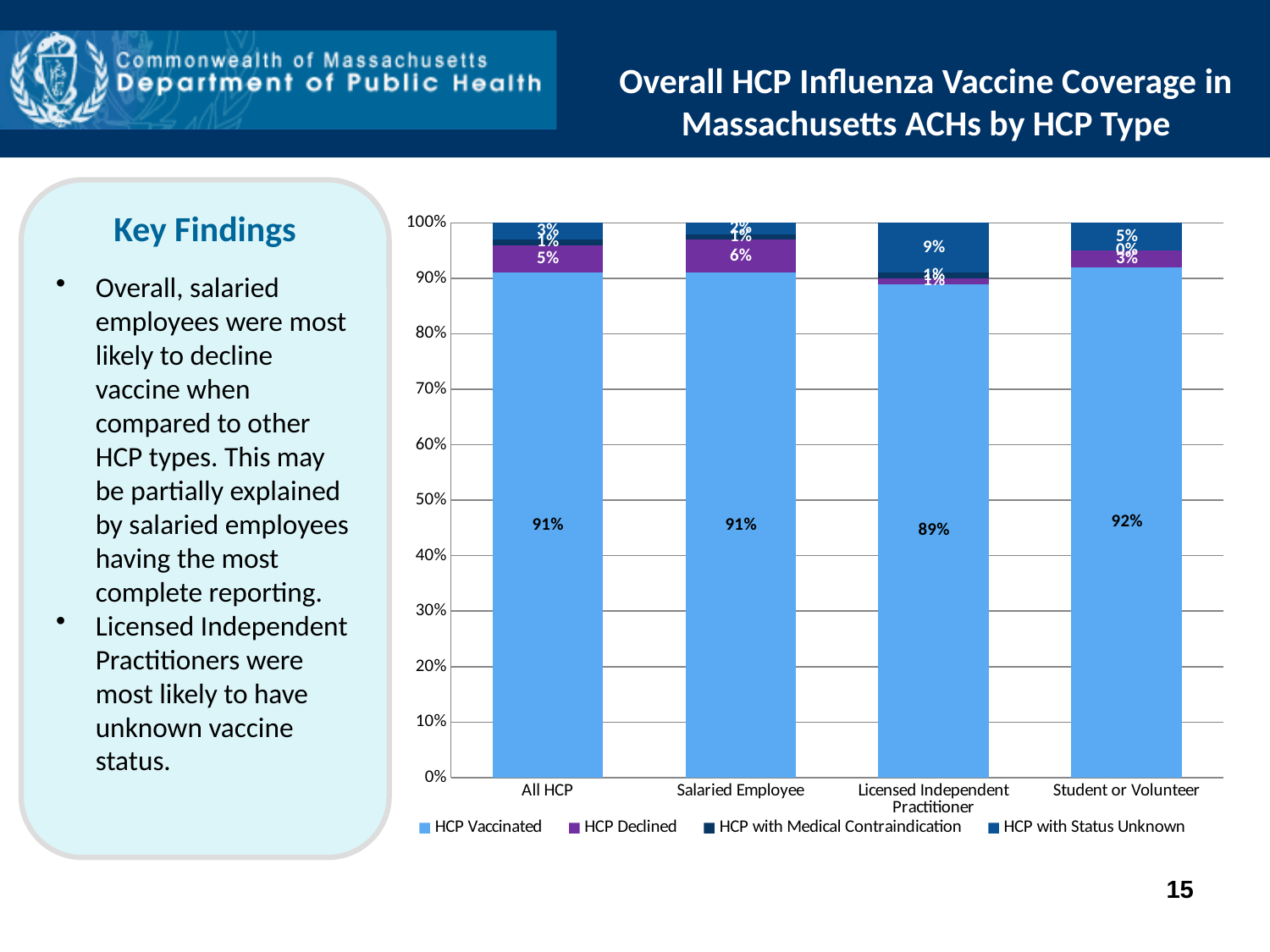
What is the HCP with Status Unknown value for Licensed Independent Practitioner? 9% How many series does the legend list? 4 Which HCP type has the lowest HCP Vaccinated value? Licensed Independent Practitioner Which HCP type has the highest HCP Vaccinated value? Student or Volunteer Which is larger, the HCP Declined value for Salaried Employee or for All HCP? Salaried Employee What is the HCP Vaccinated value for Student or Volunteer? 92% What is the HCP Vaccinated value for Licensed Independent Practitioner? 89% What is the HCP Declined value for Salaried Employee? 6% How many HCP type categories are shown on the x axis? 4 What type of chart is shown on the slide? stacked bar chart What is the title of the chart on the slide? Overall HCP Influenza Vaccine Coverage in Massachusetts ACHs by HCP Type What is the difference between the HCP Vaccinated values for Student or Volunteer and Licensed Independent Practitioner? 3%